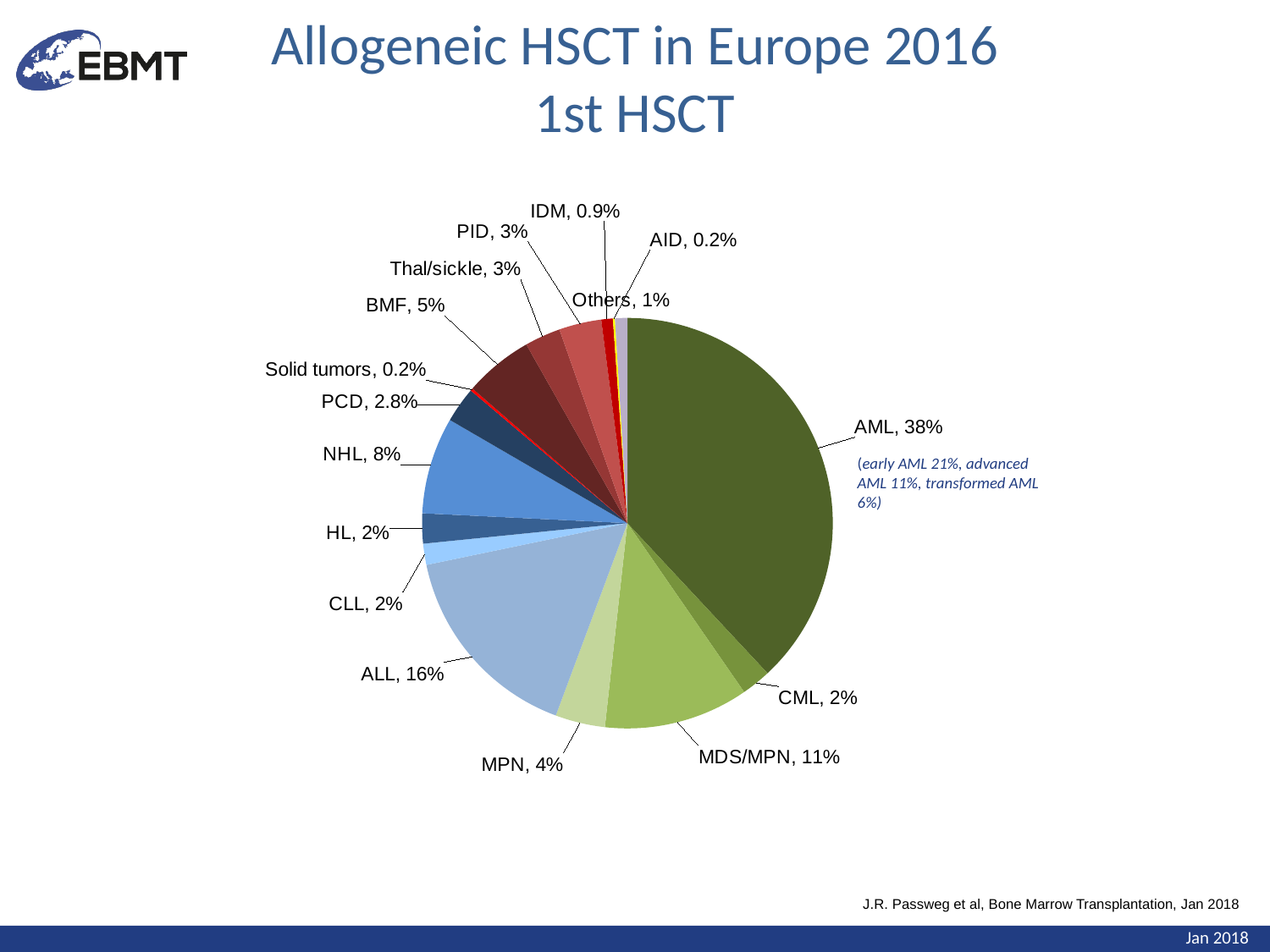
What is the value shown for IDM? 0.9% What kind of chart is shown on the slide? pie chart What is the value shown for ALL? 16% What is the value shown for MDS/MPN? 11% What share of the pie does AML account for? 38% Which category has the largest slice of the pie? AML Which is larger, the share for NHL or the share for BMF? NHL What is the difference between the AML share and the ALL share? 22% According to the note next to the AML slice, what percentage is early AML? 21% What is the value shown for PCD? 2.8% How many categories are labelled on the pie chart? 16 What is the title of the slide containing the chart? Allogeneic HSCT in Europe 2016 1st HSCT